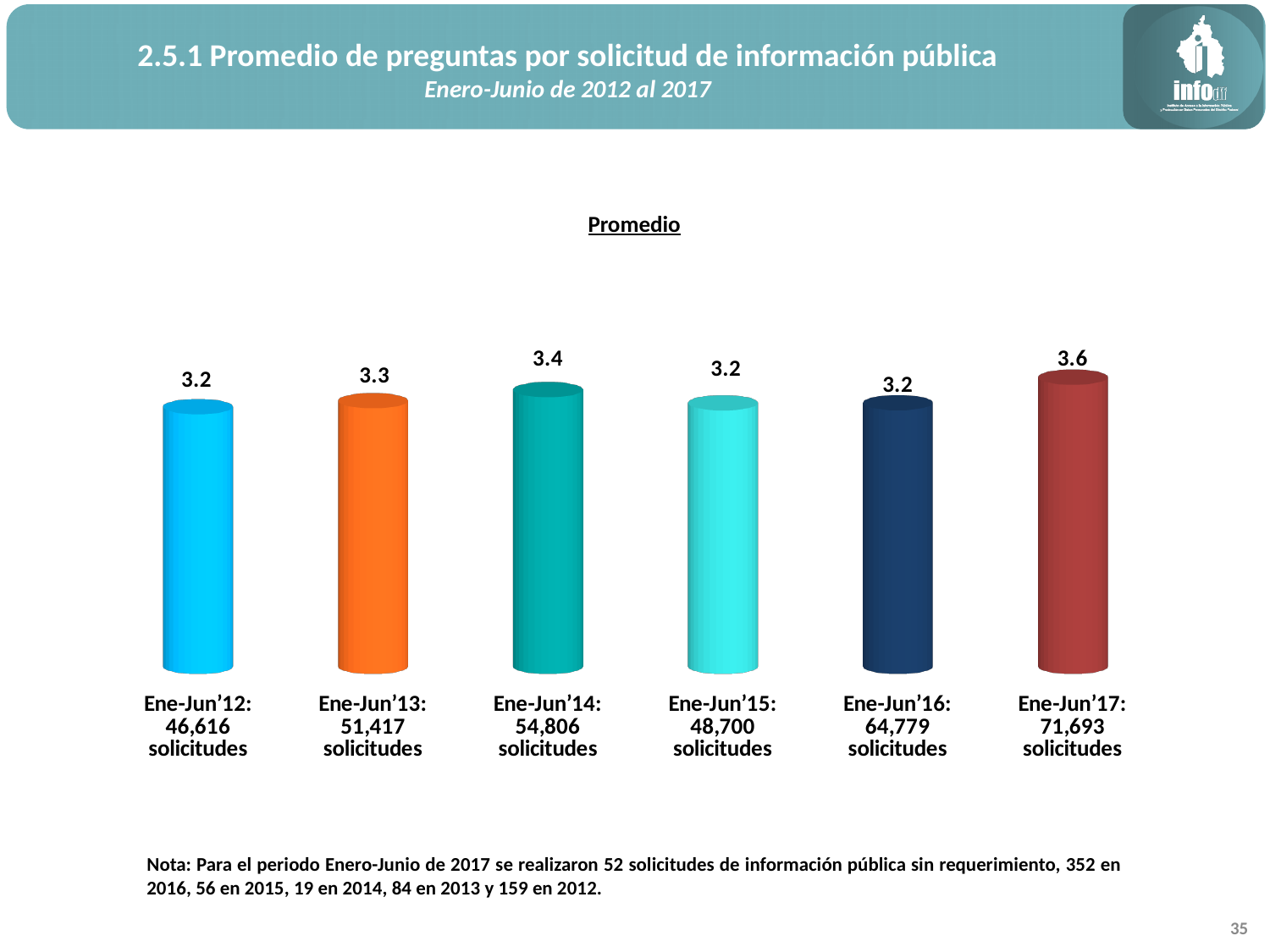
How many solicitudes are listed in the category label for Ene-Jun'16? 64,779 What is the average number of questions per request (Promedio) for Ene-Jun'17? 3.6 What is the title shown above the chart? Promedio What is the difference between the Promedio values for Ene-Jun'14 and Ene-Jun'13? 0.1 Which period has the highest Promedio value? Ene-Jun'17 What is the difference between the Promedio values for Ene-Jun'17 and Ene-Jun'12? 0.4 How many periods share the lowest Promedio value of 3.2? 3 Which is larger, the Promedio value for Ene-Jun'14 or for Ene-Jun'15? Ene-Jun'14 How many periods (bars) are shown in the chart? 6 What is the Promedio value shown for Ene-Jun'14? 3.4 What is the Promedio value shown for Ene-Jun'13? 3.3 What kind of chart is shown on the slide? Bar chart